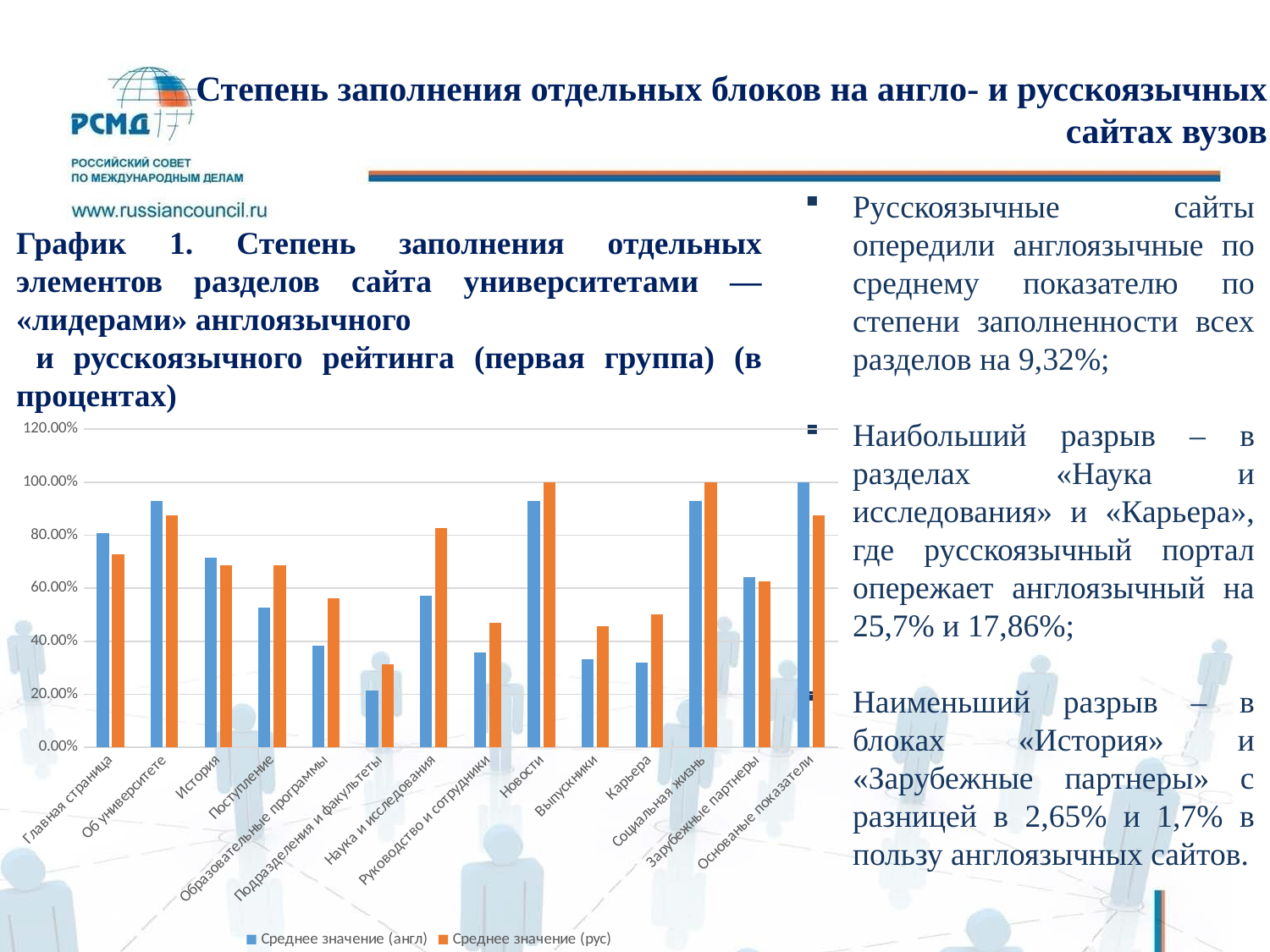
Which category has the lowest value for the series 'Среднее значение (рус)'? Подразделения и факультеты What kind of chart is shown on the slide? bar chart For the category 'Наука и исследования', which series has the larger value: 'Среднее значение (англ)' or 'Среднее значение (рус)'? Среднее значение (рус) Is the value of 'Среднее значение (англ)' for 'Об университете' greater or less than 80.00%? greater Is the value of 'Среднее значение (англ)' for 'Карьера' greater or less than 40.00%? less How many categories are shown along the x axis of the chart? 14 Which category has the lowest value for the series 'Среднее значение (англ)'? Подразделения и факультеты For the category 'Главная страница', which series has the larger value: 'Среднее значение (англ)' or 'Среднее значение (рус)'? Среднее значение (англ) Which category has the highest value for the series 'Среднее значение (англ)'? Основаные показатели How many series does the chart legend list? 2 Is the value of 'Среднее значение (рус)' for 'Наука и исследования' greater or less than 60.00%? greater Which colour represents the series 'Среднее значение (рус)' in the chart? orange